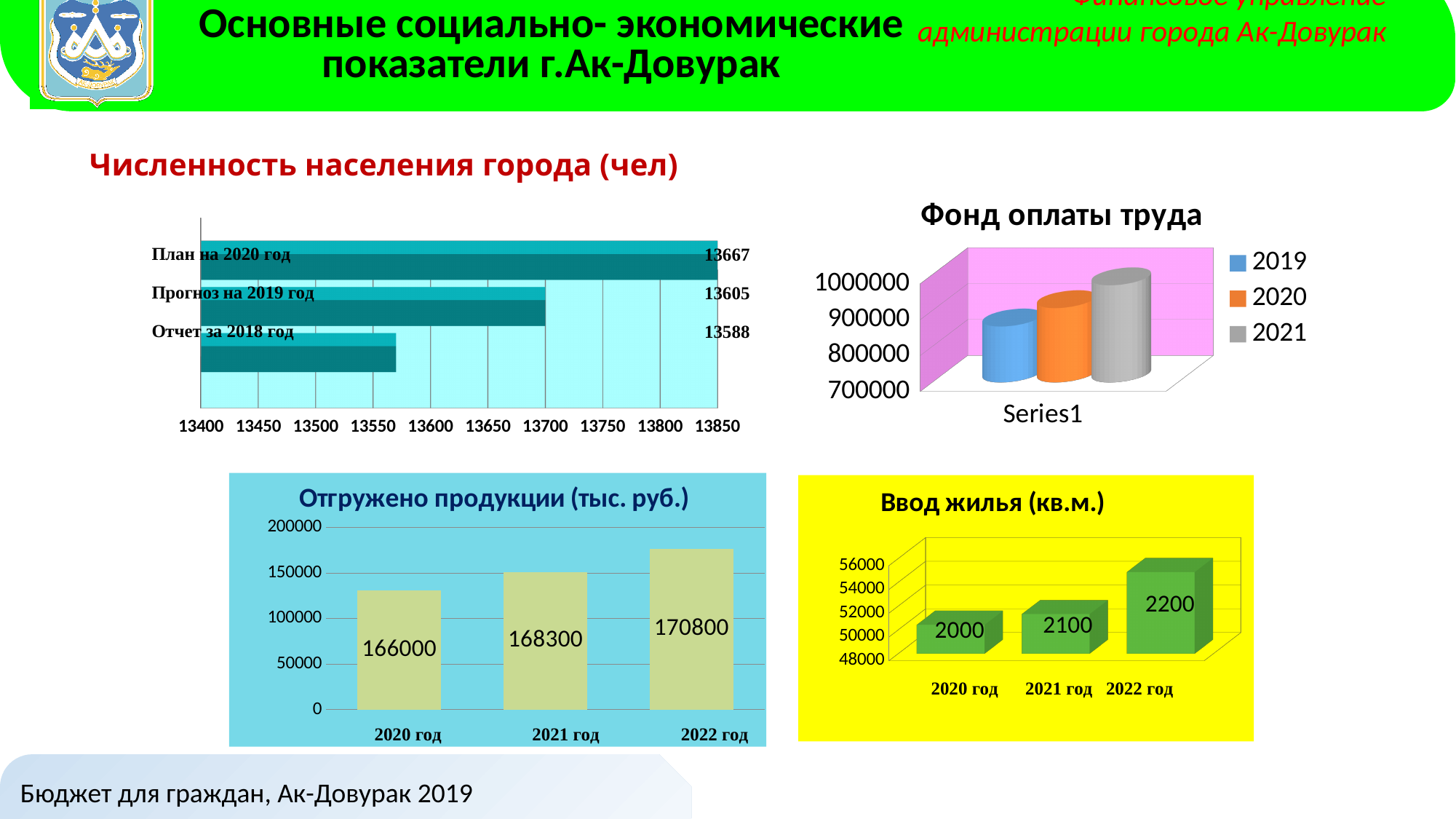
In the chart 'Ввод жилья (кв.м.)', what is the value for '2022 год'? 2200 In the chart 'Фонд оплаты труда', which series has the lowest value? 2019 In the chart 'Отгружено продукции (тыс. руб.)', what is the difference between '2022 год' and '2020 год'? 4800 In the chart 'Численность населения города (чел)', how many categories are shown? 3 In the chart 'Фонд оплаты труда', which series has the highest value? 2021 In the chart 'Численность населения города (чел)', what is the difference between 'План на 2020 год' and 'Прогноз на 2019 год'? 62 In the chart 'Отгружено продукции (тыс. руб.)', do the values rise or fall from 2020 год to 2022 год? rise In the chart 'Отгружено продукции (тыс. руб.)', what is the value for '2021 год'? 168300 In the chart 'Численность населения города (чел)', what is the value for 'Отчет за 2018 год'? 13588 In the chart 'Фонд оплаты труда', how many series does the legend list? 3 In the chart 'Численность населения города (чел)', what is the value for 'План на 2020 год'? 13667 In the chart 'Ввод жилья (кв.м.)', which year has the lowest value? 2020 год